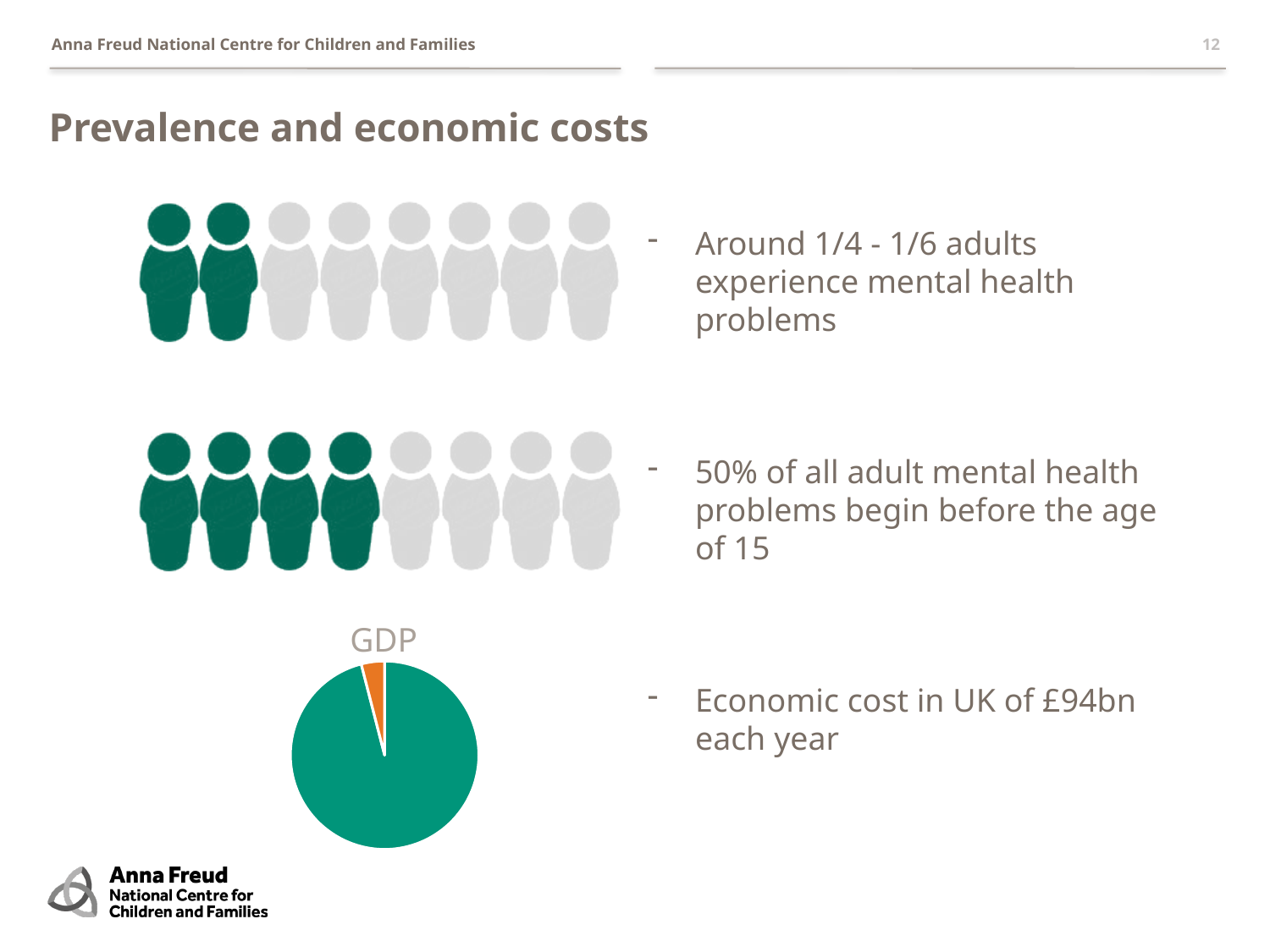
What colour is the largest slice of the GDP pie chart? teal In the GDP pie chart, which slice is larger, the teal slice or the orange slice? the teal slice What kind of chart is shown on the slide? pie chart What is the title of the pie chart? GDP In the GDP pie chart, which slice is the smallest? the orange slice How many slices does the GDP pie chart have? 2